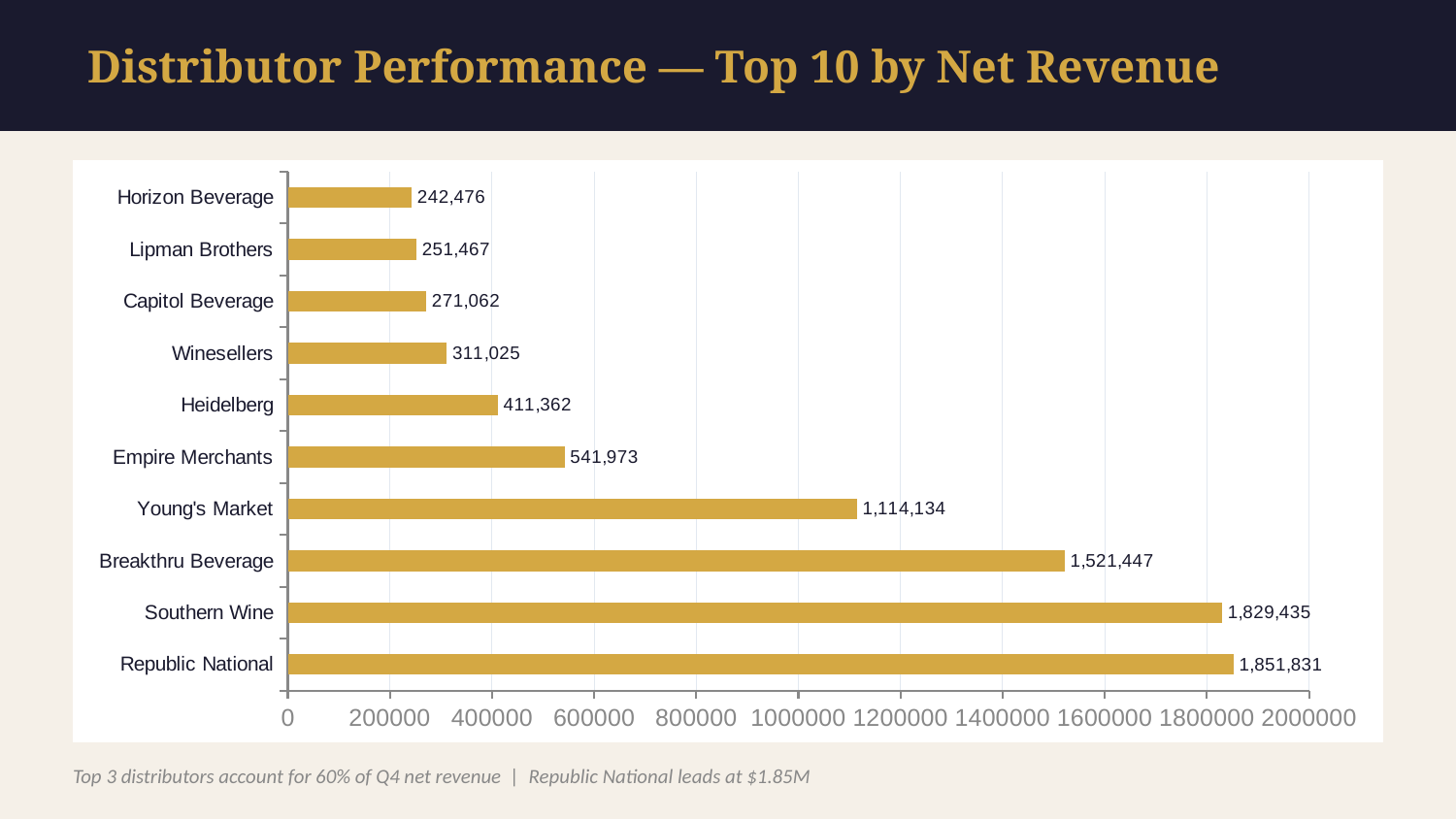
What is the difference in net revenue between Breakthru Beverage and Young's Market? 407,313 Which has a higher net revenue, Empire Merchants or Heidelberg? Empire Merchants What is the net revenue for Heidelberg? 411,362 What kind of chart is shown on the slide? Bar chart What is the net revenue for Young's Market? 1,114,134 What is the title of the slide? Distributor Performance — Top 10 by Net Revenue Is the value for Young's Market greater or less than 1000000? greater How many distributors are shown in the chart? 10 What is the difference in net revenue between Republic National and Southern Wine? 22,396 What is the net revenue for Capitol Beverage? 271,062 Which distributor has the highest net revenue? Republic National Which distributor has the lowest net revenue? Horizon Beverage